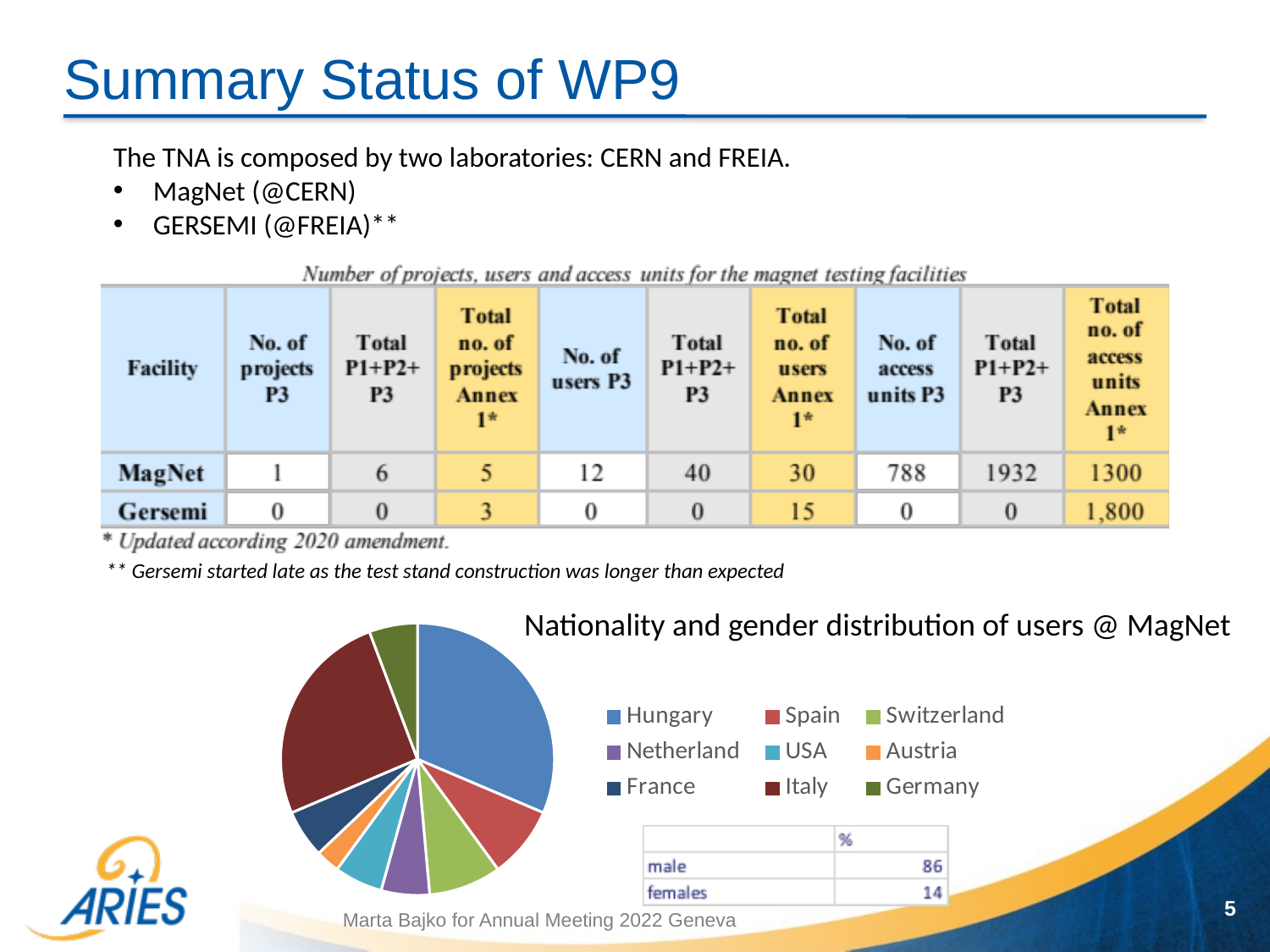
In the pie chart, which slice is larger, Italy or Spain? Italy How many slices does the pie chart have? 9 Which nationality has the largest slice in the pie chart? Hungary In the pie chart, which slice is larger, Hungary or Spain? Hungary What is the title of the pie chart? Nationality and gender distribution of users @ MagNet How many nationalities does the pie chart's legend list? 9 In the pie chart, which slice is larger, Italy or Germany? Italy What kind of chart is shown on the slide? pie chart What colour is the Hungary slice in the pie chart? blue